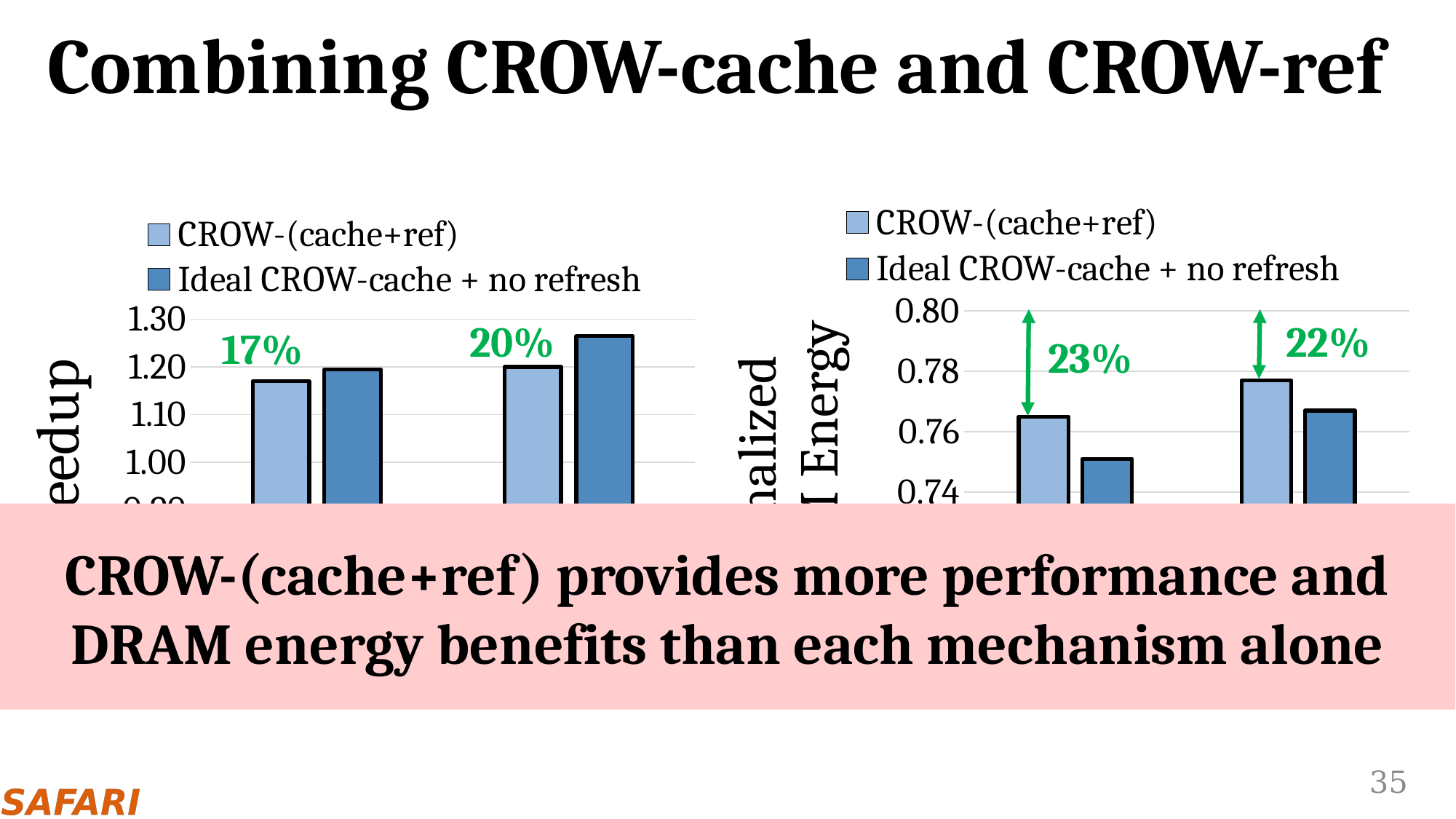
In the left chart, what are the two legend entries? CROW-(cache+ref) and Ideal CROW-cache + no refresh In the left chart, is the Ideal CROW-cache + no refresh bar in the right group greater or less than 1.20? greater In the left chart, what percentage annotation is printed above the left group of bars? 17% What kind of chart is the left chart on the slide? bar chart In the right chart, which bar is taller in the left group: CROW-(cache+ref) or Ideal CROW-cache + no refresh? CROW-(cache+ref) In the right chart, is the CROW-(cache+ref) bar in the right group greater or less than 0.78? less In the right chart, is the CROW-(cache+ref) bar in the left group greater or less than 0.76? greater In the left chart, which bar is taller in the right group: CROW-(cache+ref) or Ideal CROW-cache + no refresh? Ideal CROW-cache + no refresh How many series does the legend of the left chart list? 2 How many series does the legend of the right chart list? 2